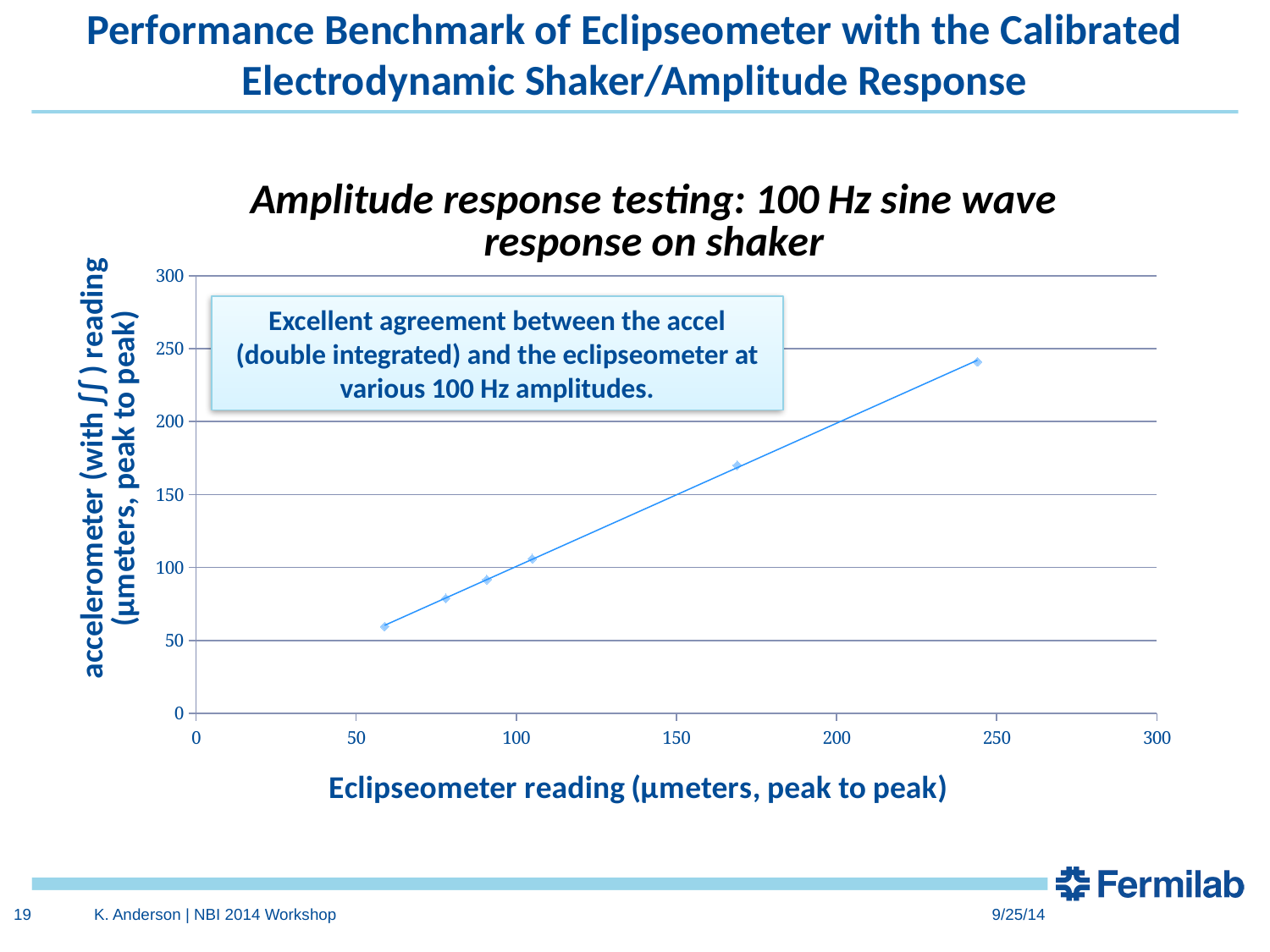
What kind of chart is shown on the slide? scatter chart What is the title of the chart? Amplitude response testing: 100 Hz sine wave response on shaker How many data points are plotted on the chart? 6 What is the label of the x axis of the chart? Eclipseometer reading (µmeters, peak to peak) Is the accelerometer reading for the rightmost data point greater or less than 200? greater Do the accelerometer readings rise or fall as the eclipseometer reading increases along the x axis? rise Is the accelerometer reading for the leftmost data point greater or less than 100? less What is the maximum value shown on the y axis? 300 Is the eclipseometer reading of the rightmost data point greater or less than 250? less